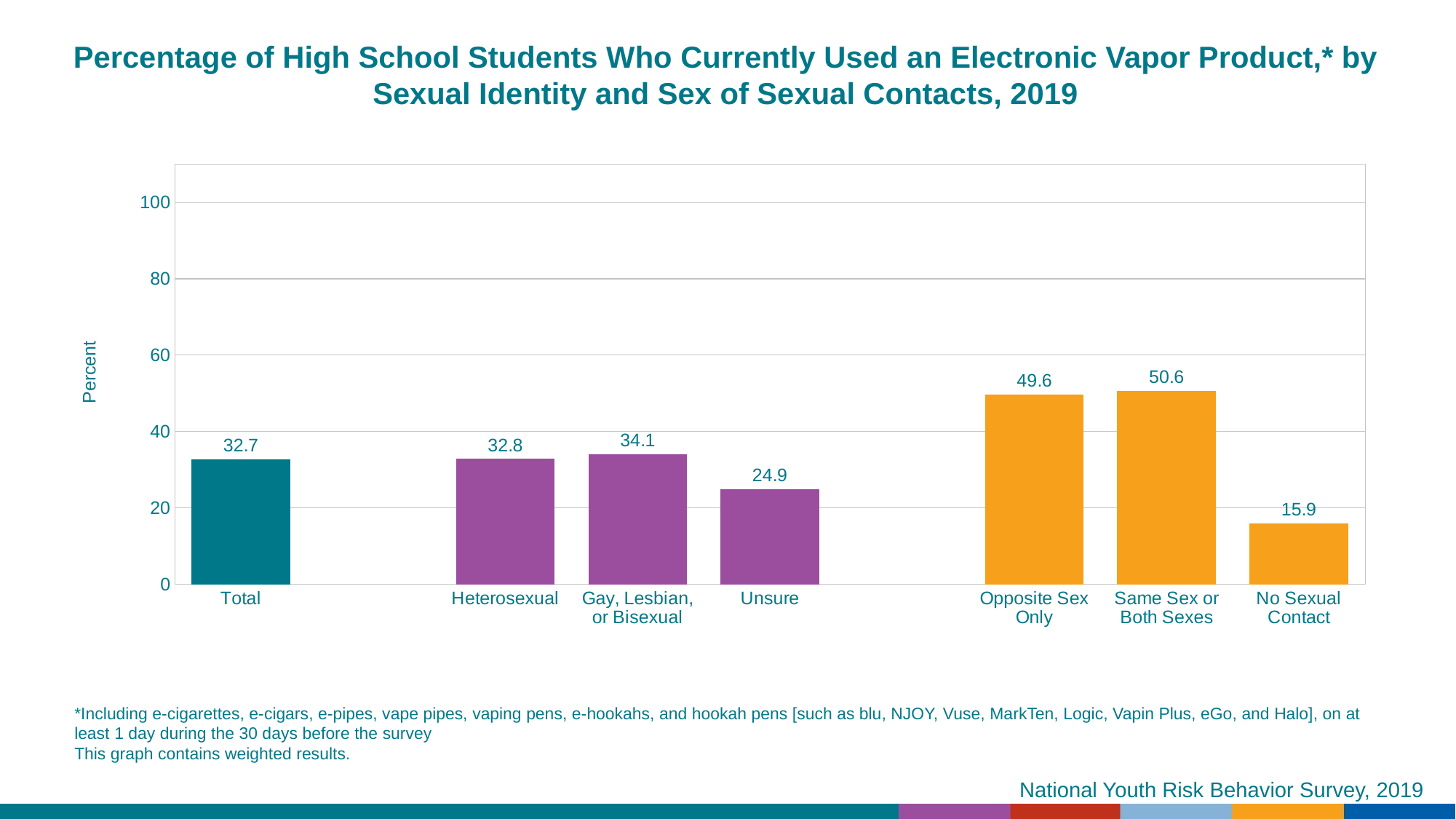
What is the value for Unsure? 24.9 What is the value for No Sexual Contact? 15.9 What is the difference between the values for Gay, Lesbian, or Bisexual and Unsure? 9.2 Which category has the highest value? Same Sex or Both Sexes Which category has the lowest value? No Sexual Contact How many categories are shown on the x axis? 7 What is the label of the y axis? Percent Which is larger, the value for Gay, Lesbian, or Bisexual or the value for Unsure? Gay, Lesbian, or Bisexual What is the difference between the values for Opposite Sex Only and No Sexual Contact? 33.7 Is the value for Opposite Sex Only greater or less than 40? greater What kind of chart is this? bar chart What is the value for Total? 32.7